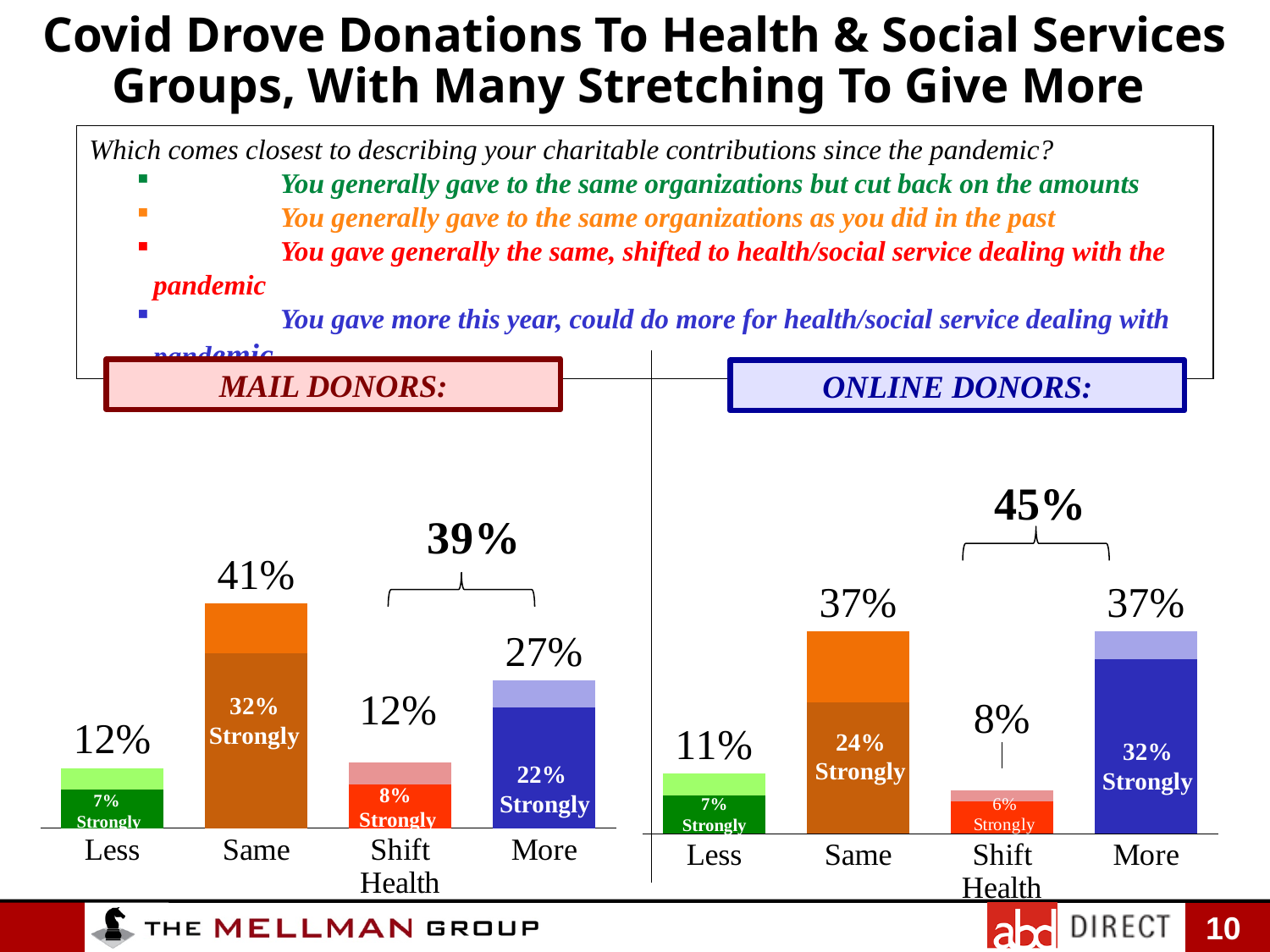
In the Mail Donors chart, what is the 'Strongly' percentage within the More bar? 22% What kind of chart is used for the Mail Donors data? Bar chart In the Online Donors chart, what percentage is shown for the More category? 37% In the Mail Donors chart, what percentage is shown for the Same category? 41% Which is larger in the Mail Donors chart: the percentage for Less or the percentage for More? More How many categories are shown on the x axis of the Online Donors chart? 4 In the Online Donors chart, what combined percentage is shown by the bracket above Shift Health and More? 45% In the Mail Donors chart, what is the difference between the Same and More percentages? 14% In the Online Donors chart, which category has the lowest percentage? Shift Health In the Online Donors chart, what is the 'Strongly' percentage within the Same bar? 24% In the Mail Donors chart, which category has the highest percentage? Same In the Online Donors chart, what is the difference between the Less and Shift Health percentages? 3%